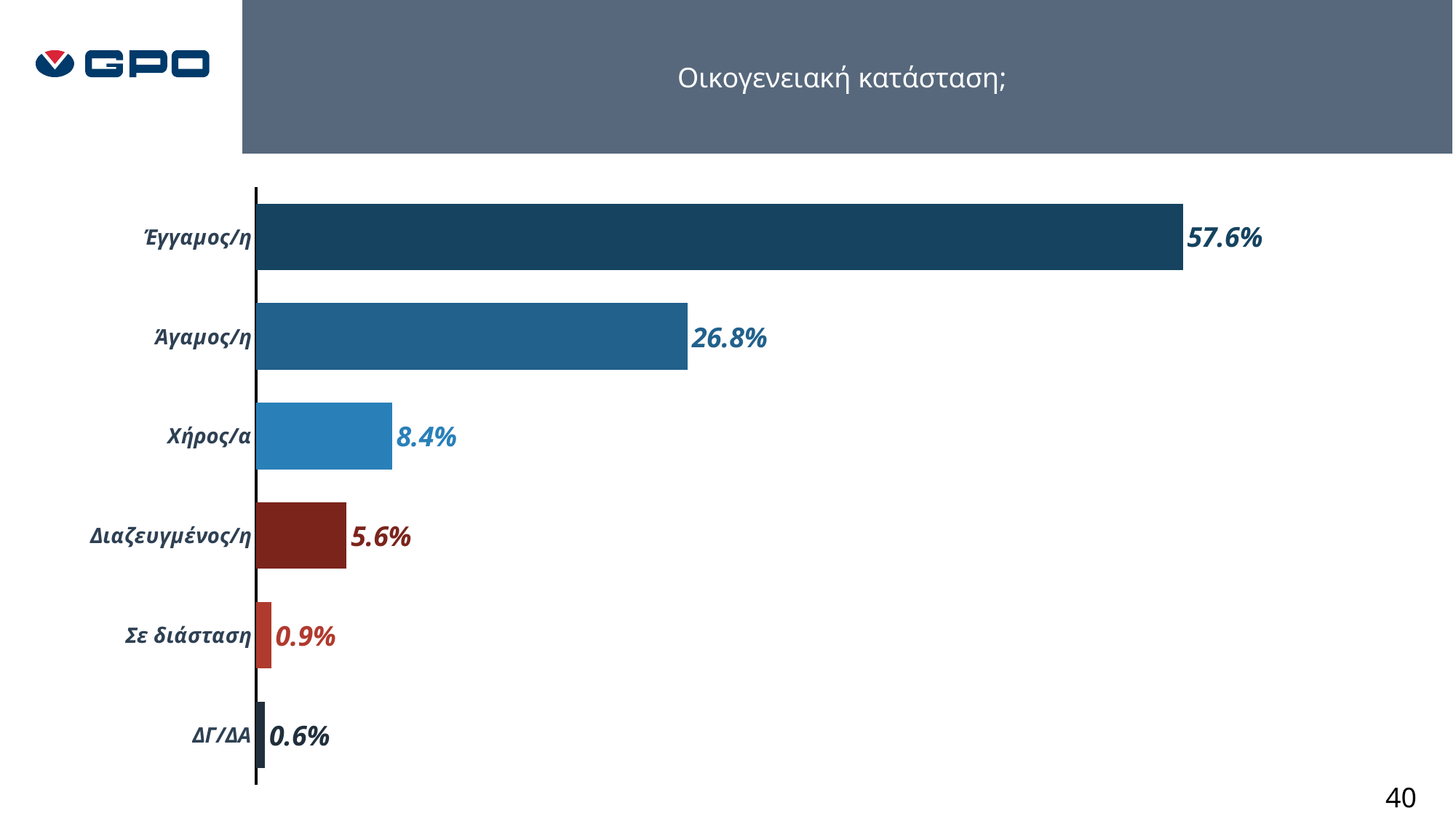
What is the value for Χήρος/α? 8.4% What is the title of the chart? Οικογενειακή κατάσταση; What is the value for Διαζευγμένος/η? 5.6% What kind of chart is shown on the slide? Bar chart What is the value for Έγγαμος/η? 57.6% Which category has the highest value? Έγγαμος/η Which is larger, the value for Χήρος/α or the value for Διαζευγμένος/η? Χήρος/α How many categories are shown in the chart? 6 What is the difference between the values for Έγγαμος/η and Άγαμος/η? 30.8% What is the value for Άγαμος/η? 26.8% Which category has the lowest value? ΔΓ/ΔΑ What is the value for Σε διάσταση? 0.9%